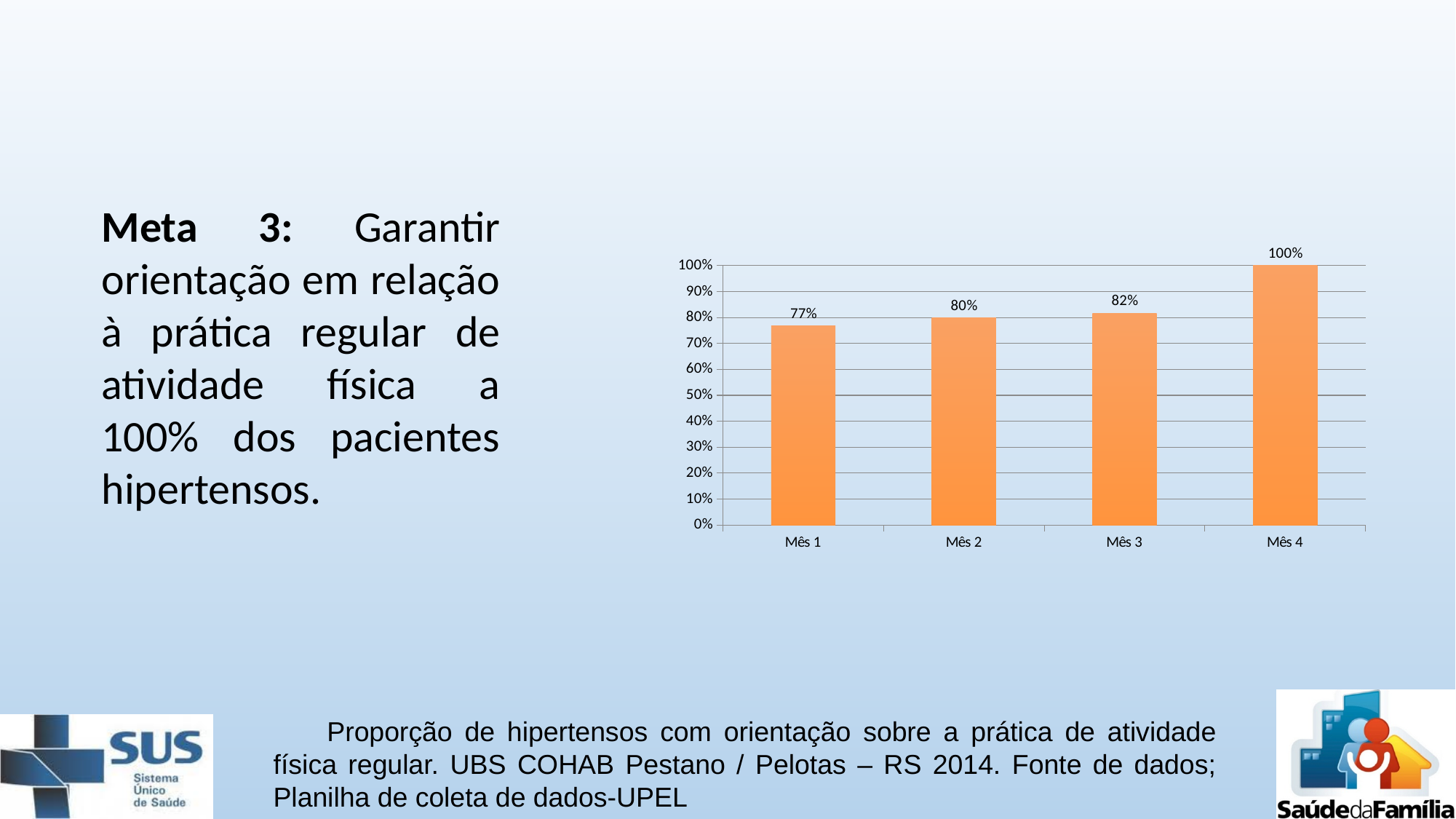
What is the difference between the values for Mês 4 and Mês 1? 23% What is the difference between the values for Mês 2 and Mês 1? 3% What is the value for Mês 4? 100% What kind of chart is shown on the slide? bar chart What is the value for Mês 3? 82% Is the value for Mês 3 greater or less than 90%? less How many months are shown on the x axis? 4 Which month has the highest value? Mês 4 Which is larger, the value for Mês 2 or the value for Mês 4? Mês 4 What is the value for Mês 1? 77% Which month has the lowest value? Mês 1 Do the values rise or fall from Mês 1 to Mês 4? rise